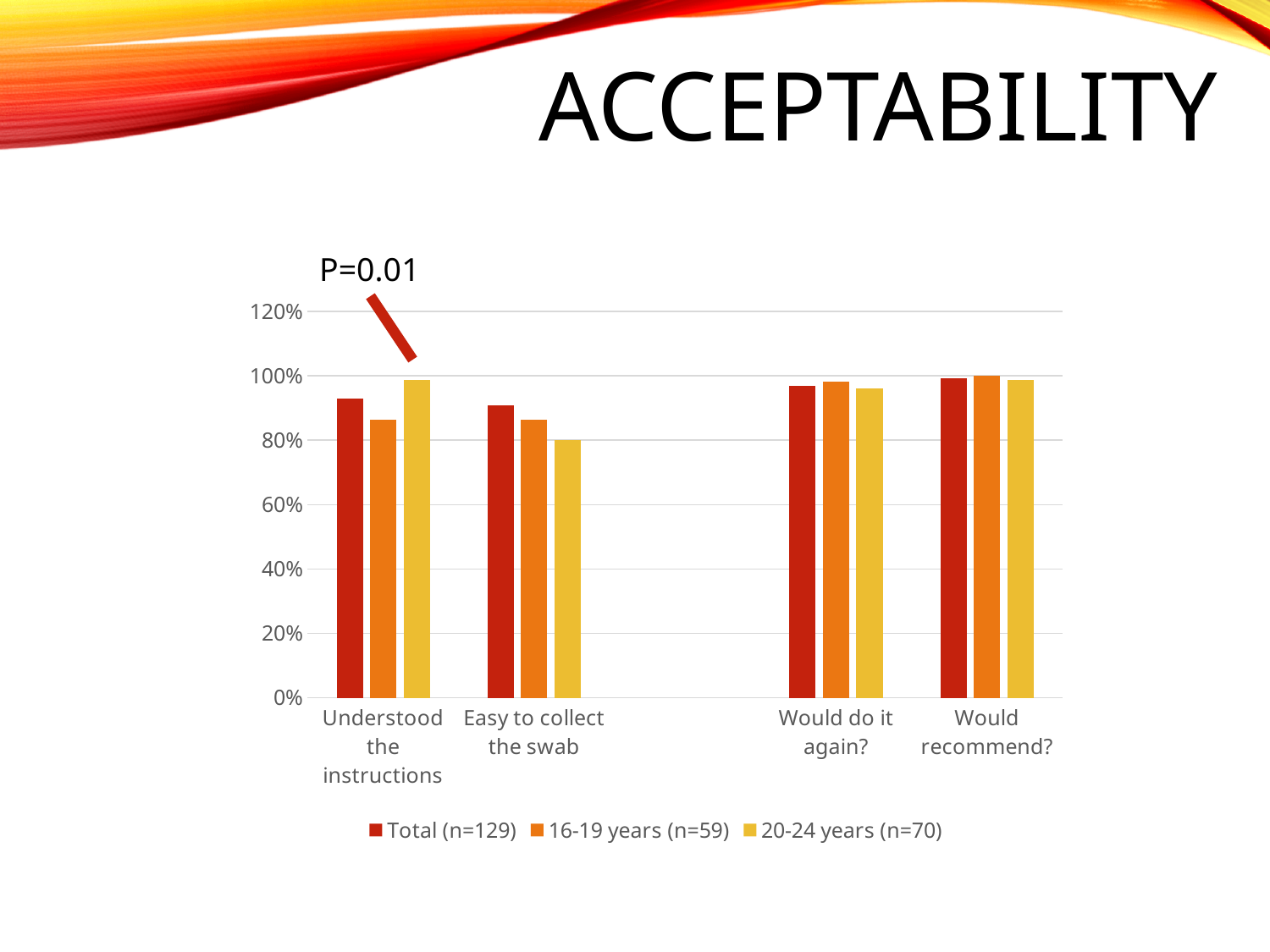
Is the value for 20-24 years on 'Easy to collect the swab' greater or less than 100%? less What is the title of the slide containing the chart? ACCEPTABILITY For 'Understood the instructions', which is larger: the value for 16-19 years or for 20-24 years? 20-24 years How many series does the legend list? 3 Which series has the highest value for 'Understood the instructions'? 20-24 years (n=70) How many labeled categories are shown on the x axis? 4 What kind of chart is shown on the slide? bar chart Is the value for 16-19 years on 'Understood the instructions' greater or less than 80%? greater What p-value annotation is shown above the 'Understood the instructions' bars? P=0.01 Is the value for Total on 'Would recommend?' greater or less than 80%? greater Which series has the lowest value for 'Easy to collect the swab'? 20-24 years (n=70) For 'Easy to collect the swab', which is larger: the value for Total or for 20-24 years? Total